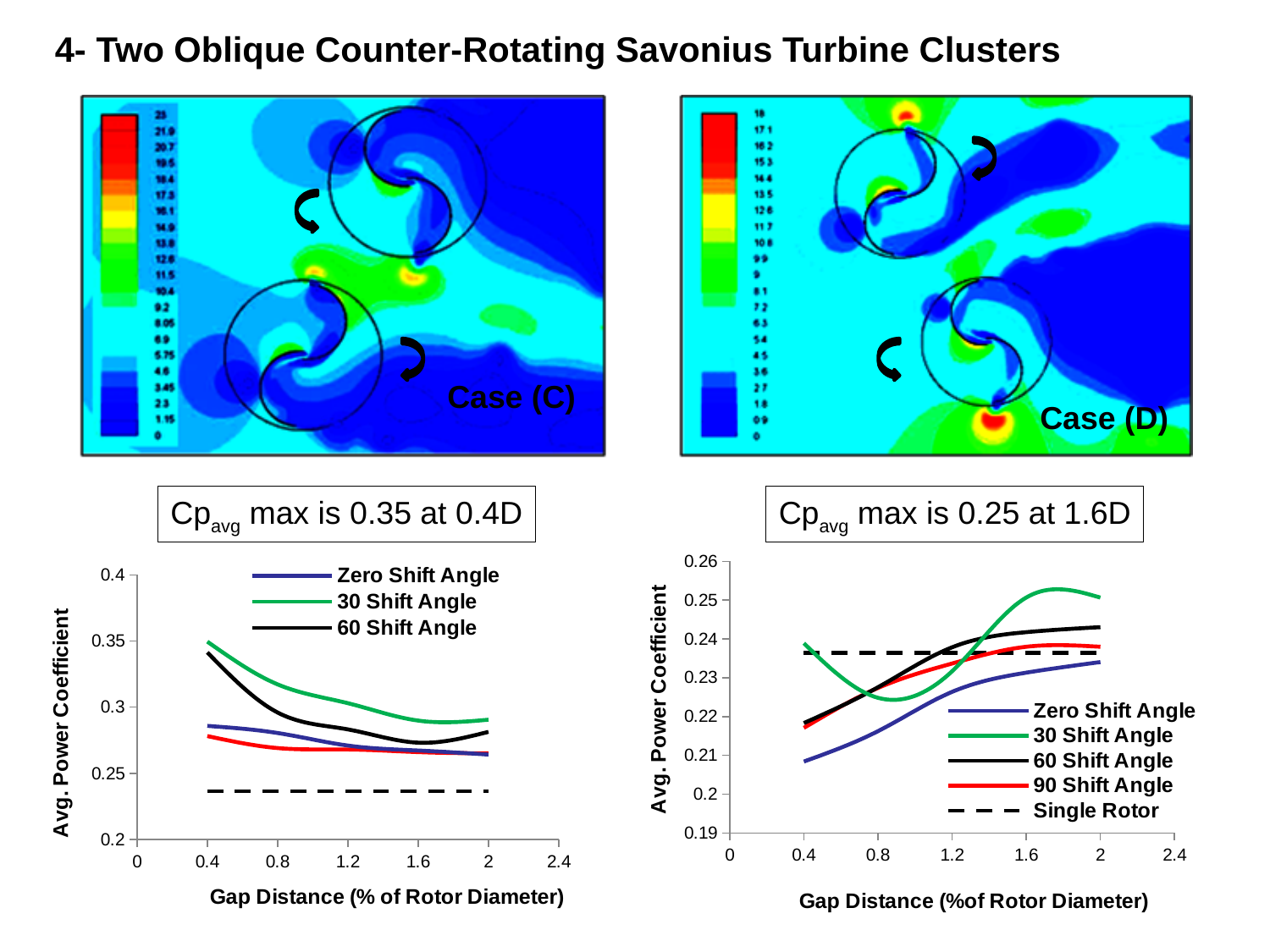
In the bottom-left chart (Case C), is the value of the Zero Shift Angle line at gap distance 0.4 greater or less than 0.3? less In the bottom-right chart (Case D), which series has the highest value at gap distance 2? 30 Shift Angle In the bottom-right chart (Case D), is the value of the Zero Shift Angle line at gap distance 0.4 greater or less than 0.22? less What kind of chart is the bottom-left chart (Case C)? line chart In the bottom-left chart (Case C), is the value of the 60 Shift Angle line at gap distance 0.4 greater or less than 0.3? greater In the bottom-right chart (Case D), does the Zero Shift Angle line rise or fall as gap distance increases from 0.4 to 2? rise How many series does the legend of the bottom-right chart (Case D) list? 5 In the bottom-right chart (Case D), which series has the lowest value at gap distance 0.4? Zero Shift Angle How many series does the legend of the bottom-left chart (Case C) list? 3 In the bottom-left chart (Case C), does the 30 Shift Angle line rise or fall as gap distance increases from 0.4 to 2? fall What is the y-axis title of the bottom-left chart (Case C)? Avg. Power Coefficient